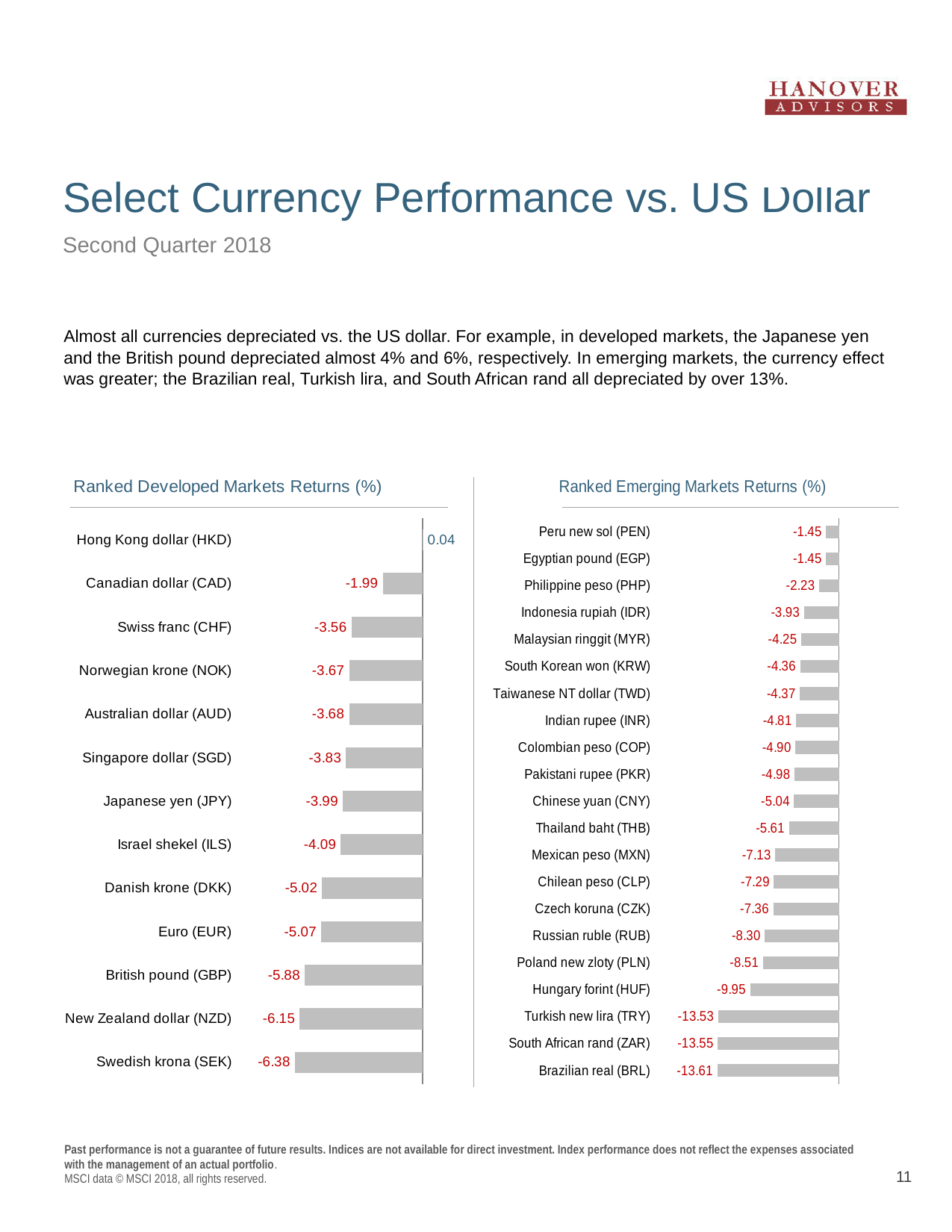
How many currencies are shown in the Ranked Developed Markets Returns (%) chart? 13 What kind of chart is the Ranked Emerging Markets Returns (%) chart? Bar chart In the Ranked Developed Markets Returns (%) chart, what is the difference between the British pound (GBP) and the Euro (EUR) values? 0.81 In the Ranked Developed Markets Returns (%) chart, which currency has the lowest return? Swedish krona (SEK) In the Ranked Developed Markets Returns (%) chart, what is the value for the Japanese yen (JPY)? -3.99 In the Ranked Developed Markets Returns (%) chart, what is the difference between the Hong Kong dollar (HKD) and the Canadian dollar (CAD) values? 2.03 In the Ranked Emerging Markets Returns (%) chart, what is the value for the Brazilian real (BRL)? -13.61 In the Ranked Emerging Markets Returns (%) chart, which currency has the lowest return? Brazilian real (BRL) In the Ranked Emerging Markets Returns (%) chart, what is the value for the Hungary forint (HUF)? -9.95 In the Ranked Developed Markets Returns (%) chart, which currency has the highest return? Hong Kong dollar (HKD) In the Ranked Emerging Markets Returns (%) chart, which is larger, the value for the Mexican peso (MXN) or the Russian ruble (RUB)? Mexican peso (MXN) How many currencies are shown in the Ranked Emerging Markets Returns (%) chart? 21